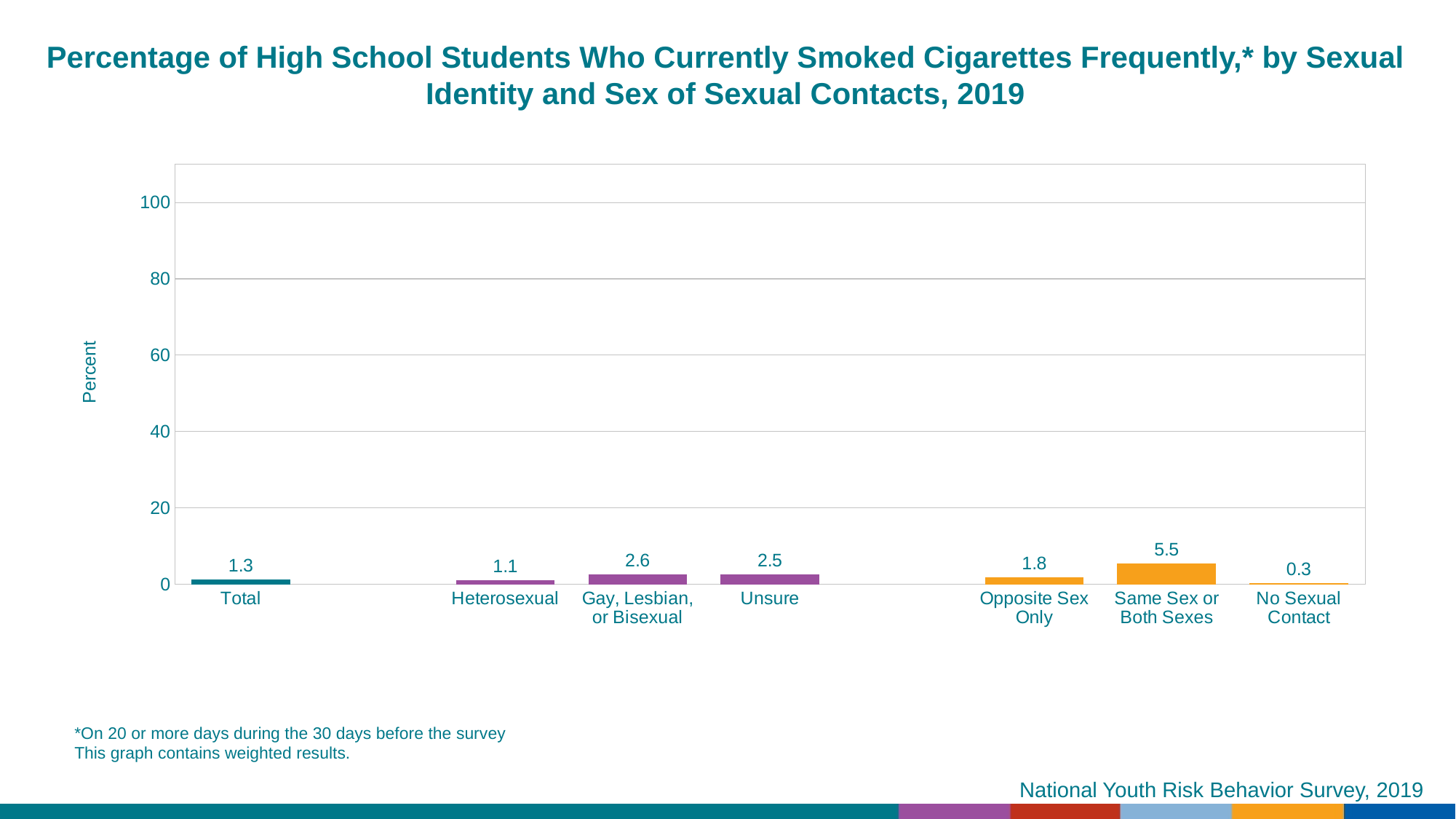
Which category has the lowest value? No Sexual Contact Is the value for Same Sex or Both Sexes greater or less than 20? less Which is larger, the value for Opposite Sex Only or the value for Total? Opposite Sex Only What kind of chart is shown on the slide? bar chart Which category has the highest value? Same Sex or Both Sexes How many categories are shown on the x axis? 7 What is the value for No Sexual Contact? 0.3 What is the difference between the values for Same Sex or Both Sexes and Opposite Sex Only? 3.7 What is the value for Total? 1.3 What is the value for Heterosexual? 1.1 What is the value for Same Sex or Both Sexes? 5.5 What is the difference between the values for Gay, Lesbian, or Bisexual and Heterosexual? 1.5